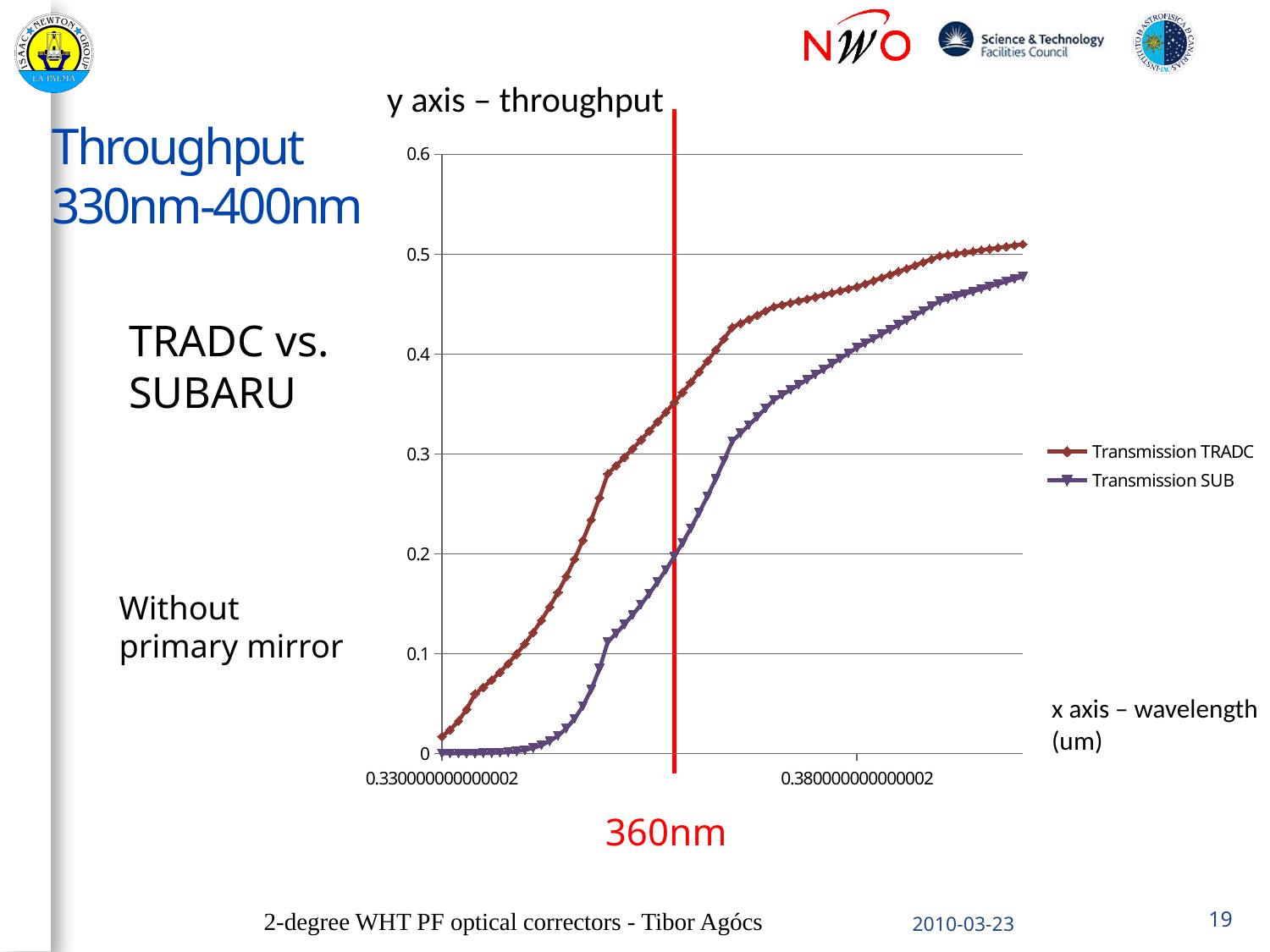
What kind of chart is shown on the slide? line chart Is the Transmission TRADC value at the x-axis tick 0.380000000000002 greater or less than 0.4? greater Is the Transmission SUB value at the x-axis tick 0.380000000000002 greater or less than 0.5? less What are the two series named in the chart legend? Transmission TRADC and Transmission SUB Is the Transmission TRADC value at the 360nm line greater or less than 0.3? greater What wavelength does the vertical red line on the chart mark? 360nm At the 360nm line, which series has the higher throughput, Transmission TRADC or Transmission SUB? Transmission TRADC Do the Transmission TRADC values rise or fall as wavelength increases along the x axis? rise How many series does the chart legend list? 2 Do the Transmission SUB values rise or fall as wavelength increases along the x axis? rise Which series lies above the other across the whole plotted wavelength range? Transmission TRADC